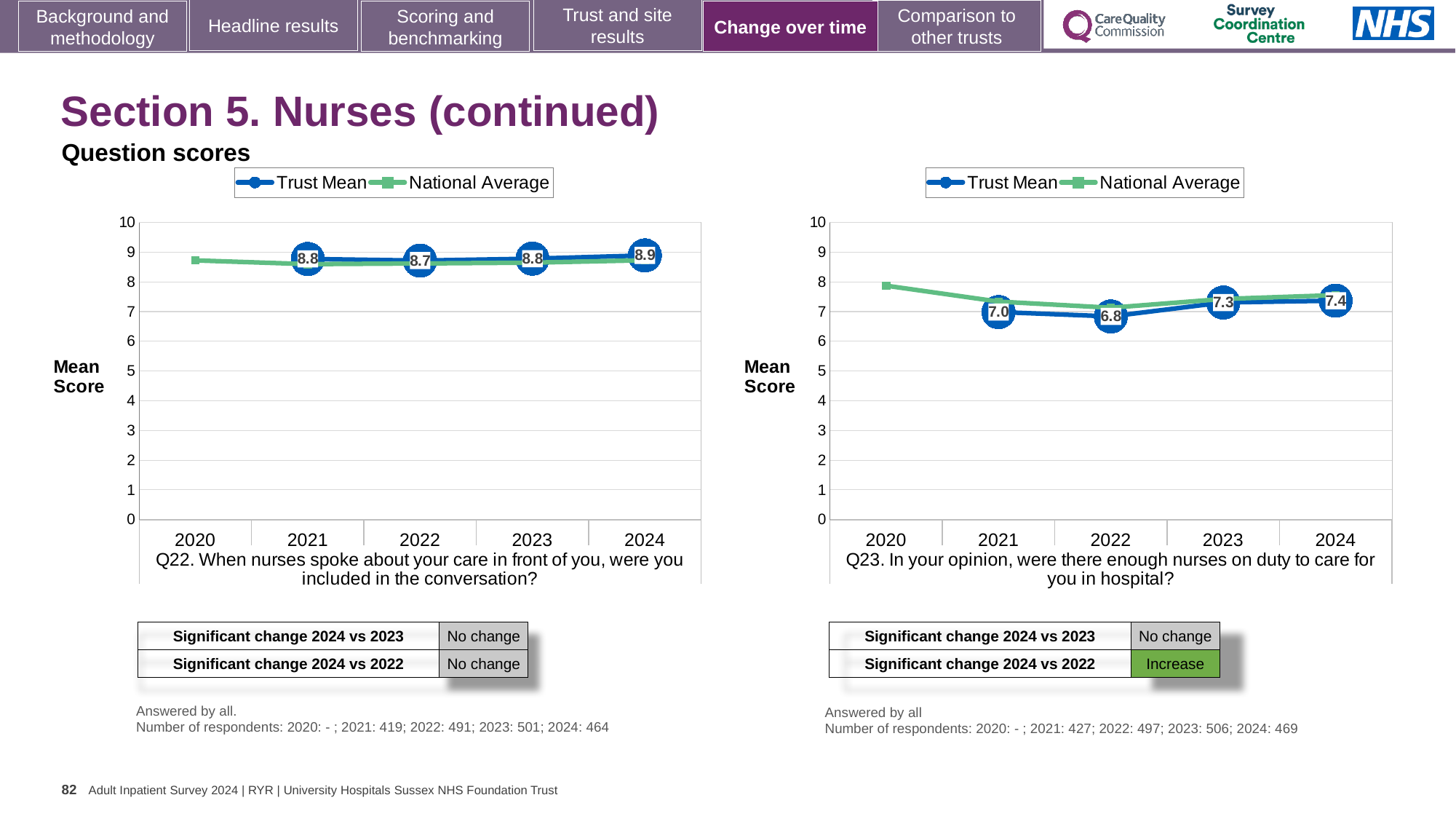
In the Q23 chart on the right, what is the Trust Mean score for 2022? 6.8 In the Q22 chart on the left, what is the Trust Mean score for 2024? 8.9 In the Q22 chart on the left, is the National Average value for 2020 greater or less than 8? greater In the Q23 chart on the right, which year has the highest Trust Mean score? 2024 How many series does the legend of the Q23 chart on the right list? 2 In the Q23 chart on the right, does the Trust Mean score rise or fall from 2022 to 2024? Rise In the Q23 chart on the right, is the Trust Mean score higher in 2021 or in 2023? 2023 In the Q22 chart on the left, which year has the lowest Trust Mean score? 2022 What type of chart is the Q22 chart on the left? Line chart In the Q23 chart on the right, is the National Average value for 2020 greater or less than 7? greater How many years are shown on the x axis of the Q22 chart on the left? 5 In the Q23 chart on the right, what is the difference between the Trust Mean scores for 2024 and 2022? 0.6